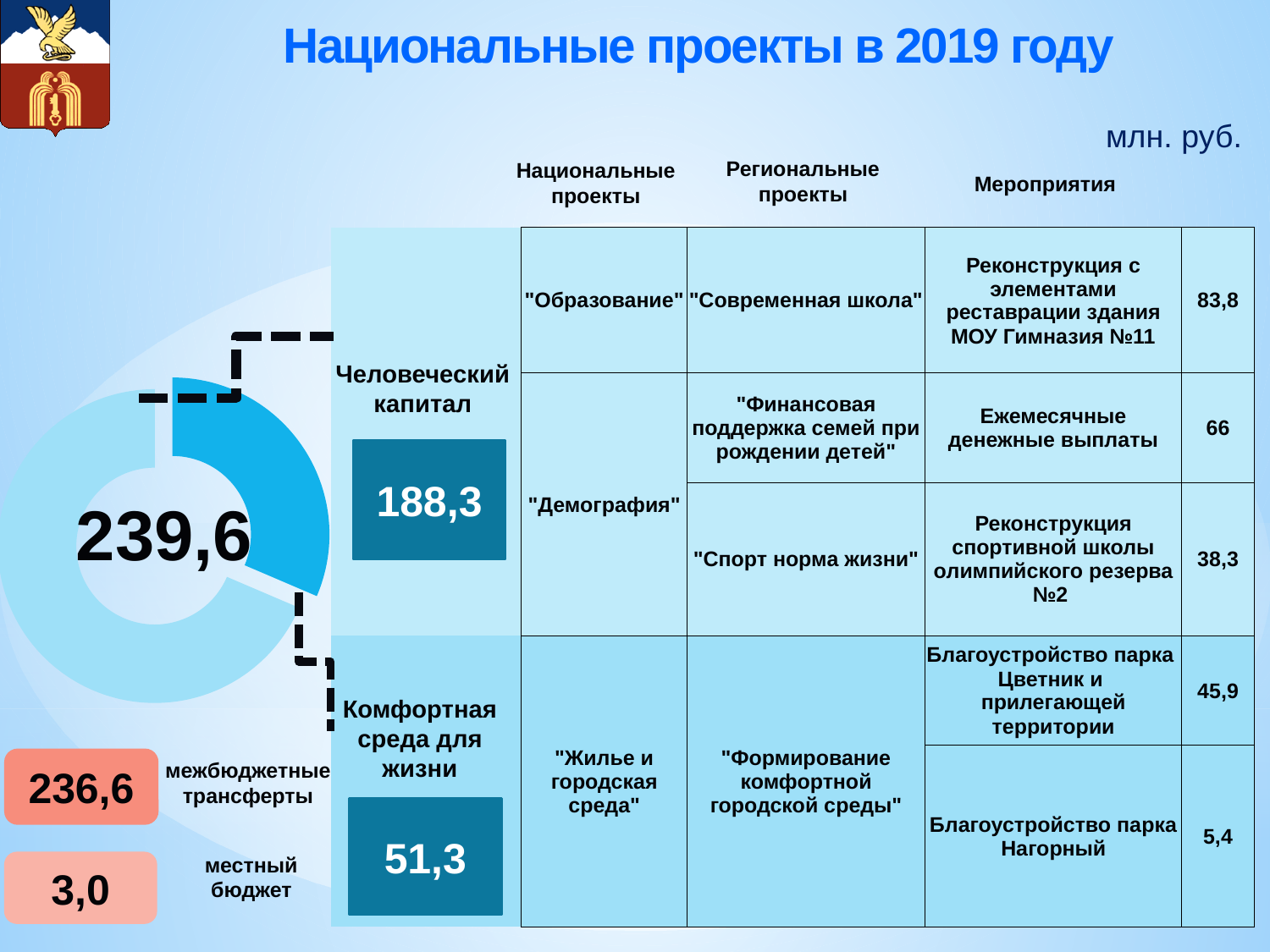
How many segments does the doughnut chart have? 2 What is the title of the slide containing the doughnut chart? Национальные проекты в 2019 году Which segment of the doughnut chart is the largest? Человеческий капитал What is the total of the two segments of the doughnut chart? 239,6 What is the value for "Комфортная среда для жизни" in the doughnut chart? 51,3 Which segment of the doughnut chart is the smallest? Комфортная среда для жизни Which is larger in the doughnut chart: "Человеческий капитал" or "Комфортная среда для жизни"? Человеческий капитал In what units are the values on the slide given? млн. руб. What is the value for "Человеческий капитал" in the doughnut chart? 188,3 What kind of chart is shown on the left of the slide? doughnut (pie) chart What value is shown in the centre of the doughnut chart? 239,6 What is the difference between the values for "Человеческий капитал" and "Комфортная среда для жизни" in the doughnut chart? 137,0